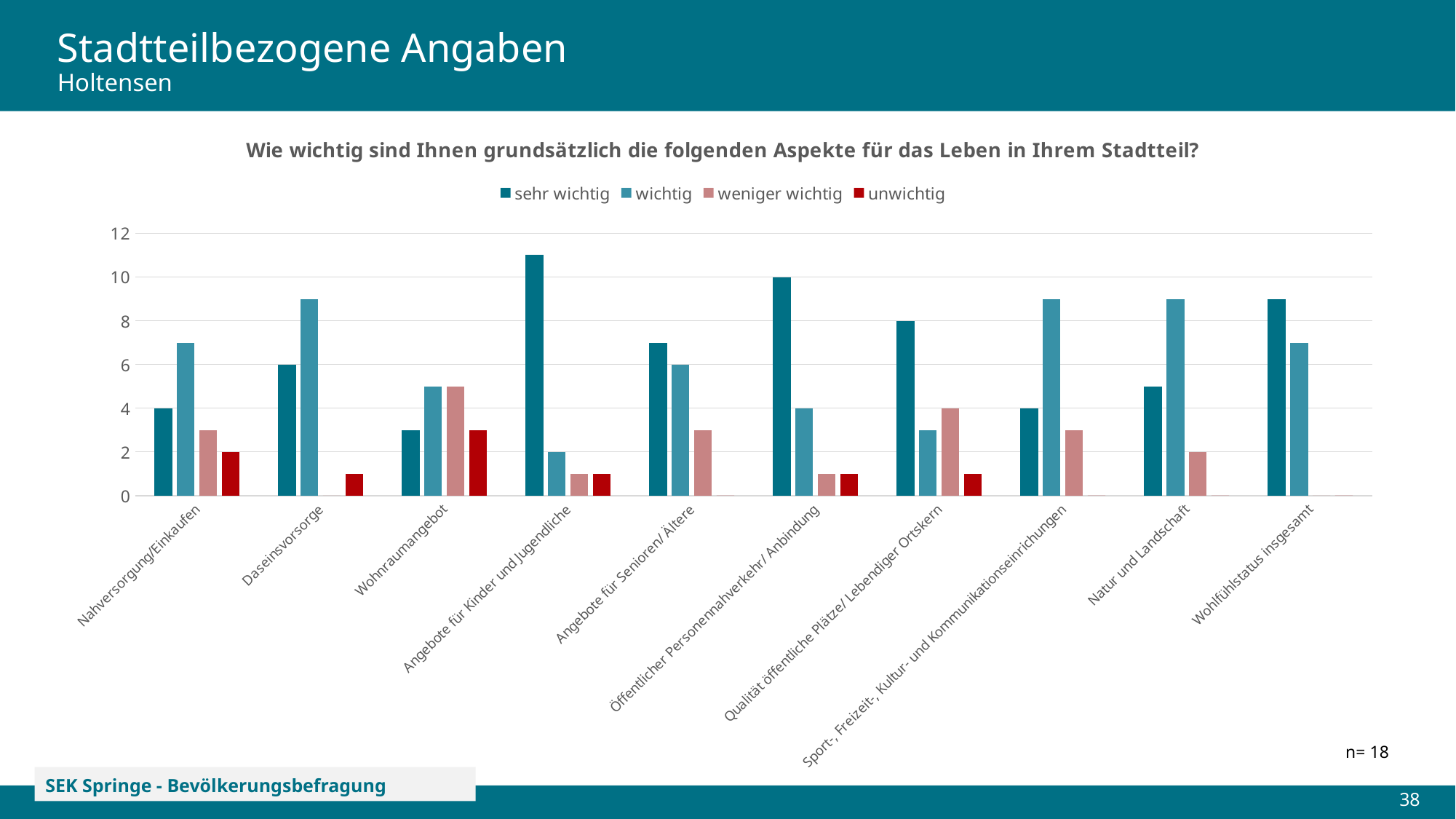
How many series does the legend list? 4 What is the value of the 'wichtig' bar for Angebote für Kinder und Jugendliche? 2 How many categories are shown on the x axis? 10 What is the value of the 'sehr wichtig' bar for Nahversorgung/Einkaufen? 4 What kind of chart is shown on the slide? bar chart What is the value of the 'sehr wichtig' bar for Qualität öffentliche Plätze/ Lebendiger Ortskern? 8 For Nahversorgung/Einkaufen, which is larger: the 'sehr wichtig' bar or the 'wichtig' bar? wichtig Is the 'wichtig' value for Daseinsvorsorge greater or less than 8? greater What is the difference between the 'sehr wichtig' and 'wichtig' values for Öffentlicher Personennahverkehr/ Anbindung? 6 Which category has the highest 'sehr wichtig' value? Angebote für Kinder und Jugendliche What is the value of the 'sehr wichtig' bar for Öffentlicher Personennahverkehr/ Anbindung? 10 Is the 'sehr wichtig' value for Wohlfühlstatus insgesamt greater or less than 8? greater